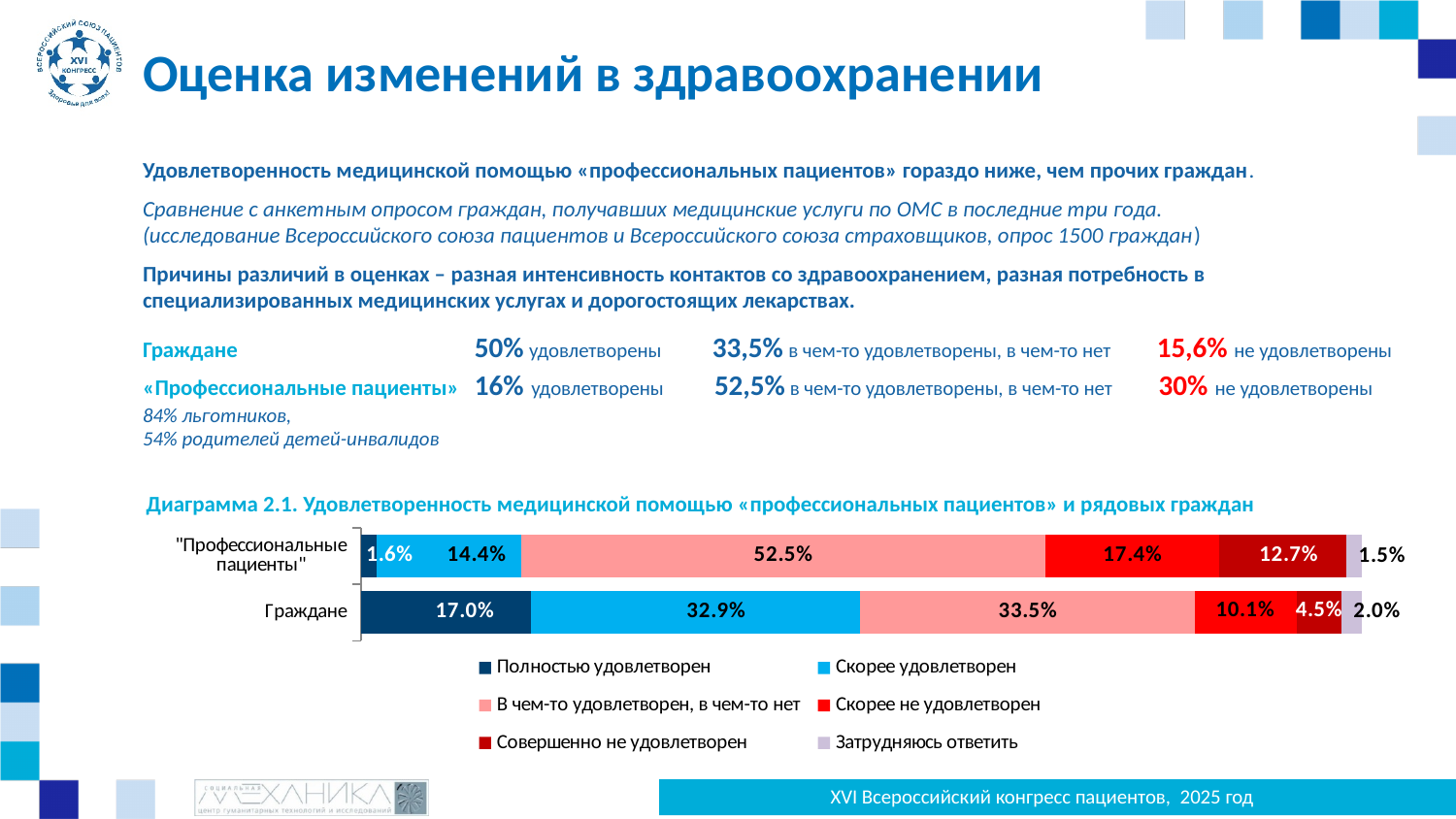
What is the value of «Скорее не удовлетворен» for «Профессиональные пациенты»? 17.4% What is the value of «В чем-то удовлетворен, в чем-то нет» for «Профессиональные пациенты»? 52.5% How many series does the chart legend list? 6 What is the value of «Полностью удовлетворен» for «Граждане»? 17.0% Which category has the higher value for «Скорее удовлетворен»: «Профессиональные пациенты» or «Граждане»? Граждане How many categories (bars) does the chart show? 2 What is the title of the chart? Диаграмма 2.1. Удовлетворенность медицинской помощью «профессиональных пациентов» и рядовых граждан What is the value of «Затрудняюсь ответить» for «Граждане»? 2.0% Which series has the smallest segment in the «Профессиональные пациенты» bar? Затрудняюсь ответить Which series has the largest segment in the «Граждане» bar? В чем-то удовлетворен, в чем-то нет What kind of chart is shown in Диаграмма 2.1? stacked bar chart What is the difference between the «Совершенно не удовлетворен» values for «Профессиональные пациенты» and «Граждане»? 8.2%